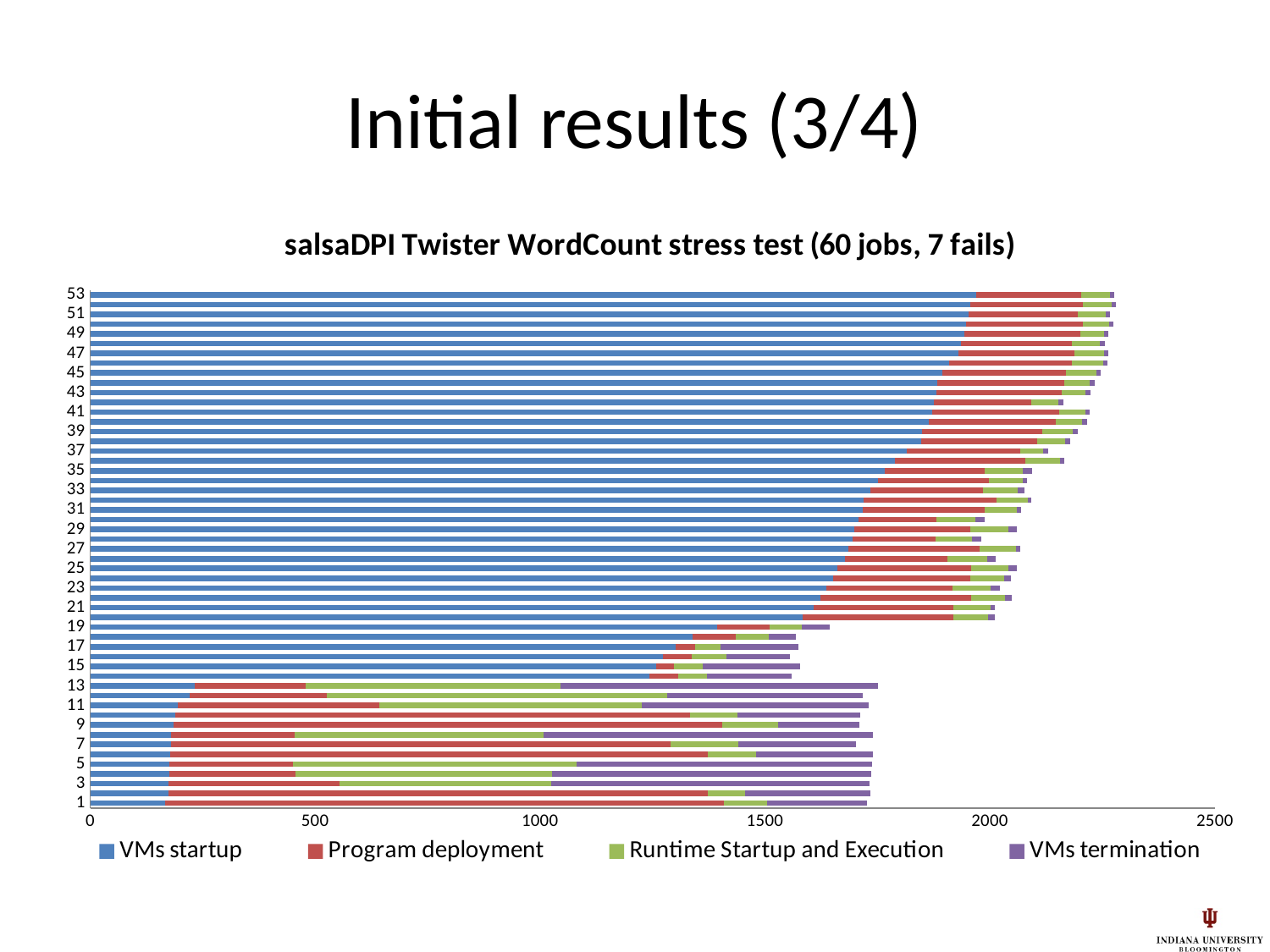
Which series is shown in blue in the legend? VMs startup Does the VMs startup segment generally increase or decrease as the job number increases from 1 to 53? Increase Which series forms the largest segment of the bar for job 53? VMs startup How many series does the legend list? 4 Is the VMs startup value for job 53 greater or less than 1500? greater What kind of chart is shown on the slide? Stacked bar chart Is the VMs startup value for job 1 greater or less than 500? less Is the total bar length for job 1 greater or less than 2000? less Which has a larger VMs startup value, job 53 or job 1? Job 53 What is the title of the chart? salsaDPI Twister WordCount stress test (60 jobs, 7 fails)